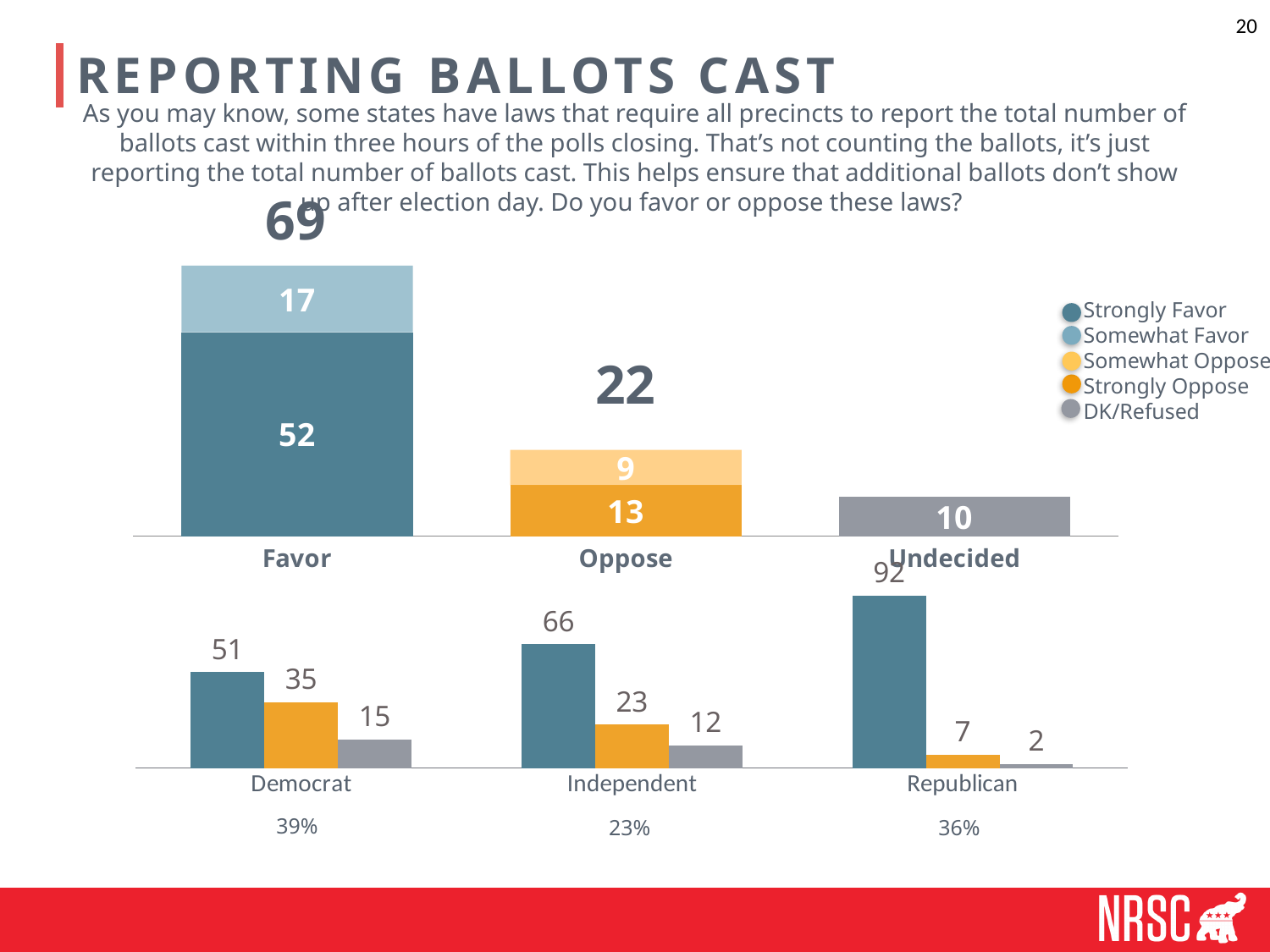
In the top stacked bar chart, what is the value for Undecided? 10 In the top stacked bar chart, what is the Somewhat Favor value in the Favor bar? 17 In the bottom chart by party, what is the value of the orange bar for Democrat? 35 In the bottom chart by party, what is the value of the blue bar for Republican? 92 In the top stacked bar chart, what is the difference between the Favor total and the Oppose total? 47 How many series does the legend of the top stacked bar chart list? 5 In the top stacked bar chart, what is the Strongly Favor value in the Favor bar? 52 In the bottom chart by party, what is the difference between the blue bar for Independent and the orange bar for Independent? 43 What kind of chart is the bottom chart by party? Bar chart In the top stacked bar chart, what is the Strongly Oppose value in the Oppose bar? 13 In the top stacked bar chart, what is the total shown for the Oppose bar? 22 In the bottom chart by party, which party has the highest blue bar? Republican